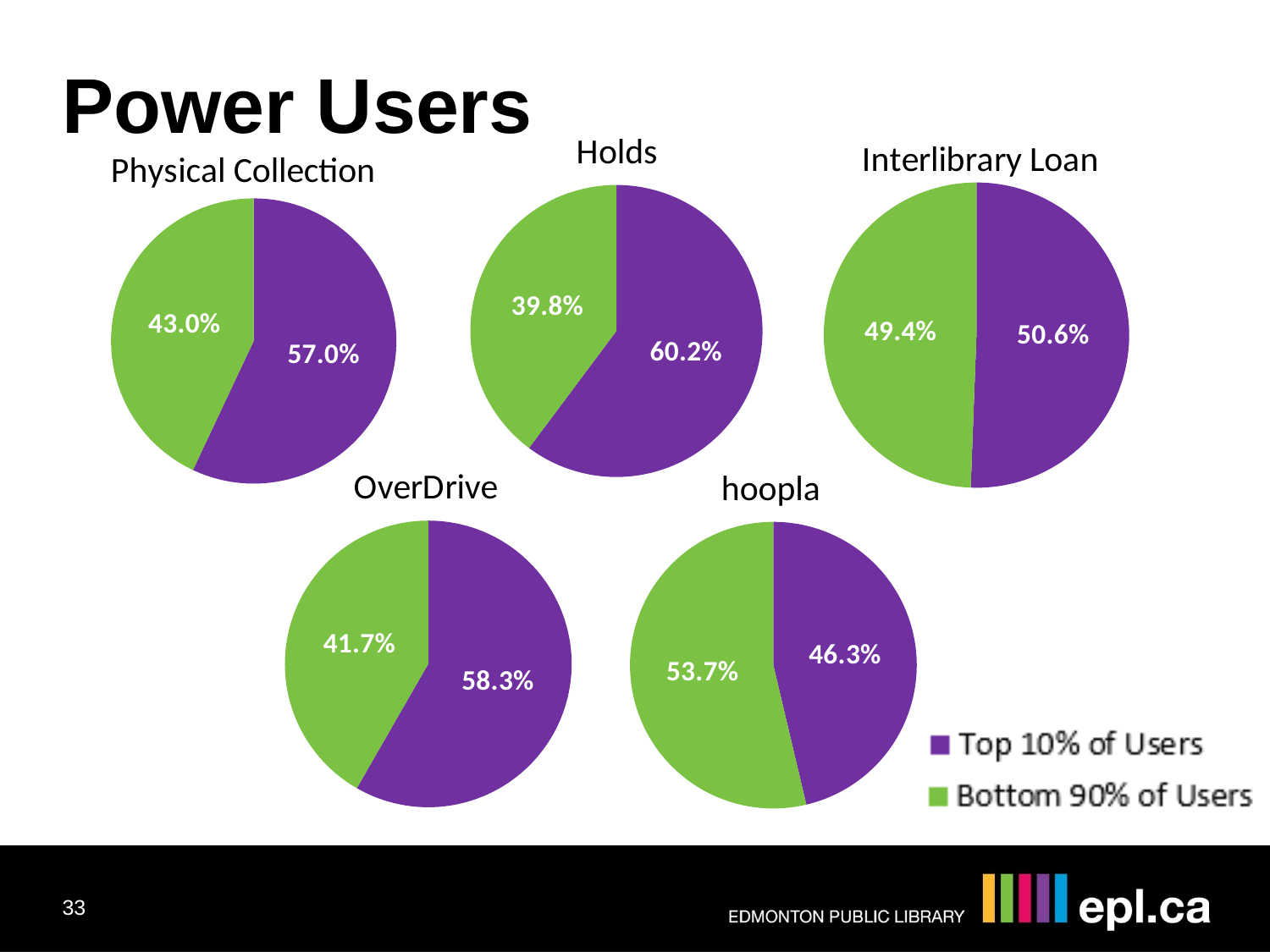
In the hoopla pie chart, what share is attributed to the Top 10% of Users? 46.3% Across the five pie charts, which chart shows the largest share for the Top 10% of Users? Holds What type of chart is used for the Physical Collection data? Pie chart In the OverDrive pie chart, what share is attributed to the Bottom 90% of Users? 41.7% Across the five pie charts, which chart shows the smallest share for the Top 10% of Users? hoopla How many pie charts are shown on the slide? 5 In the Holds pie chart, what is the difference between the Top 10% of Users share and the Bottom 90% of Users share? 20.4% In the Physical Collection pie chart, what share is attributed to the Top 10% of Users? 57.0% In the Holds pie chart, what share is attributed to the Bottom 90% of Users? 39.8% In the hoopla pie chart, which group has the larger share, Top 10% of Users or Bottom 90% of Users? Bottom 90% of Users In the Interlibrary Loan pie chart, what share is attributed to the Top 10% of Users? 50.6% How many entries does the legend list? 2